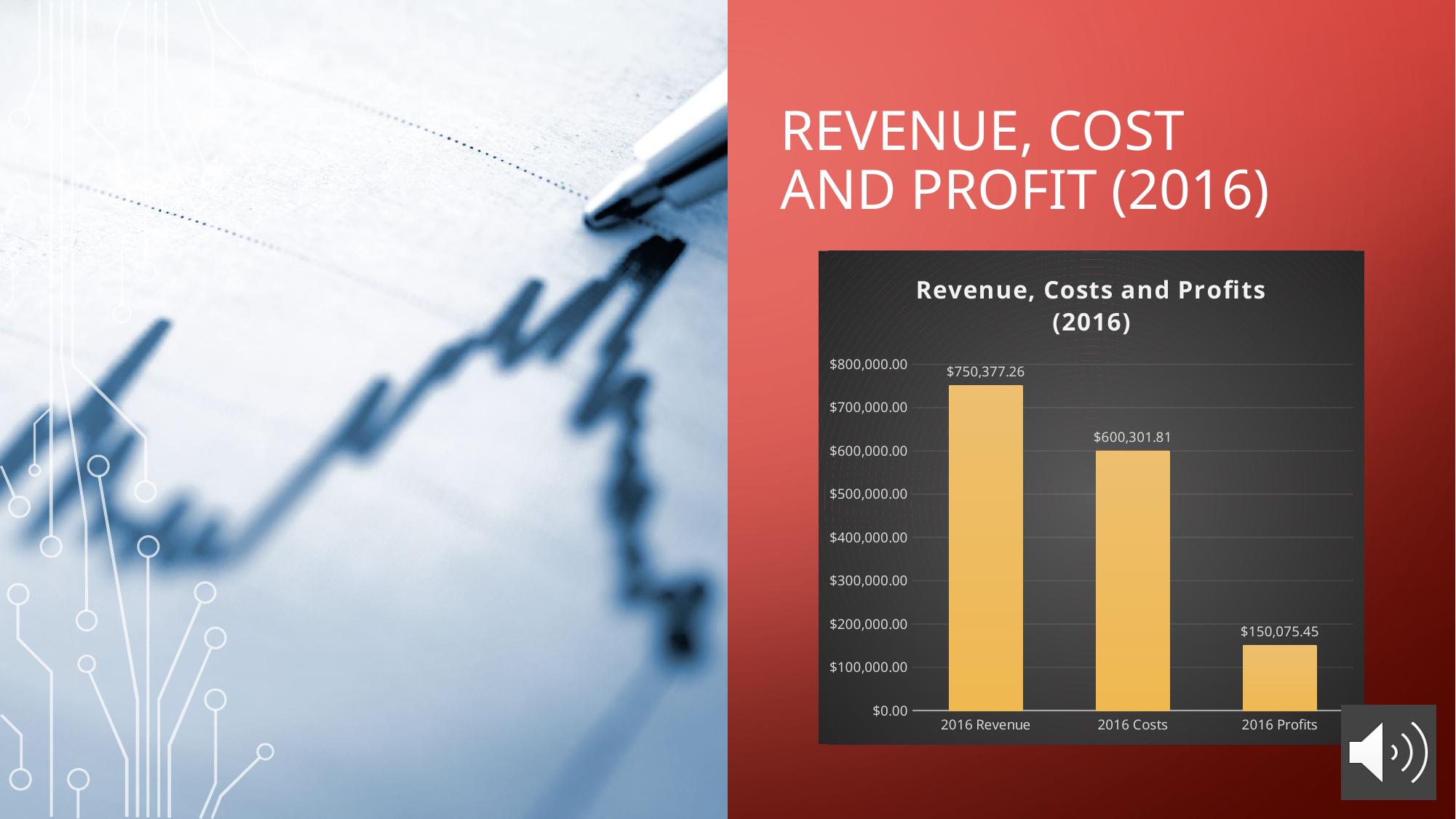
What is the title of the chart? Revenue, Costs and Profits (2016) Which category has the highest value? 2016 Revenue What is the value for 2016 Profits? $150,075.45 What is the value for 2016 Revenue? $750,377.26 Is the value for 2016 Profits greater or less than $200,000.00? less What kind of chart is shown on the slide? bar chart What is the value for 2016 Costs? $600,301.81 What is the difference between 2016 Revenue and 2016 Costs? $150,075.45 What is the difference between 2016 Costs and 2016 Profits? $450,226.36 Which is larger, 2016 Costs or 2016 Profits? 2016 Costs Which category has the lowest value? 2016 Profits How many categories are shown in the chart? 3